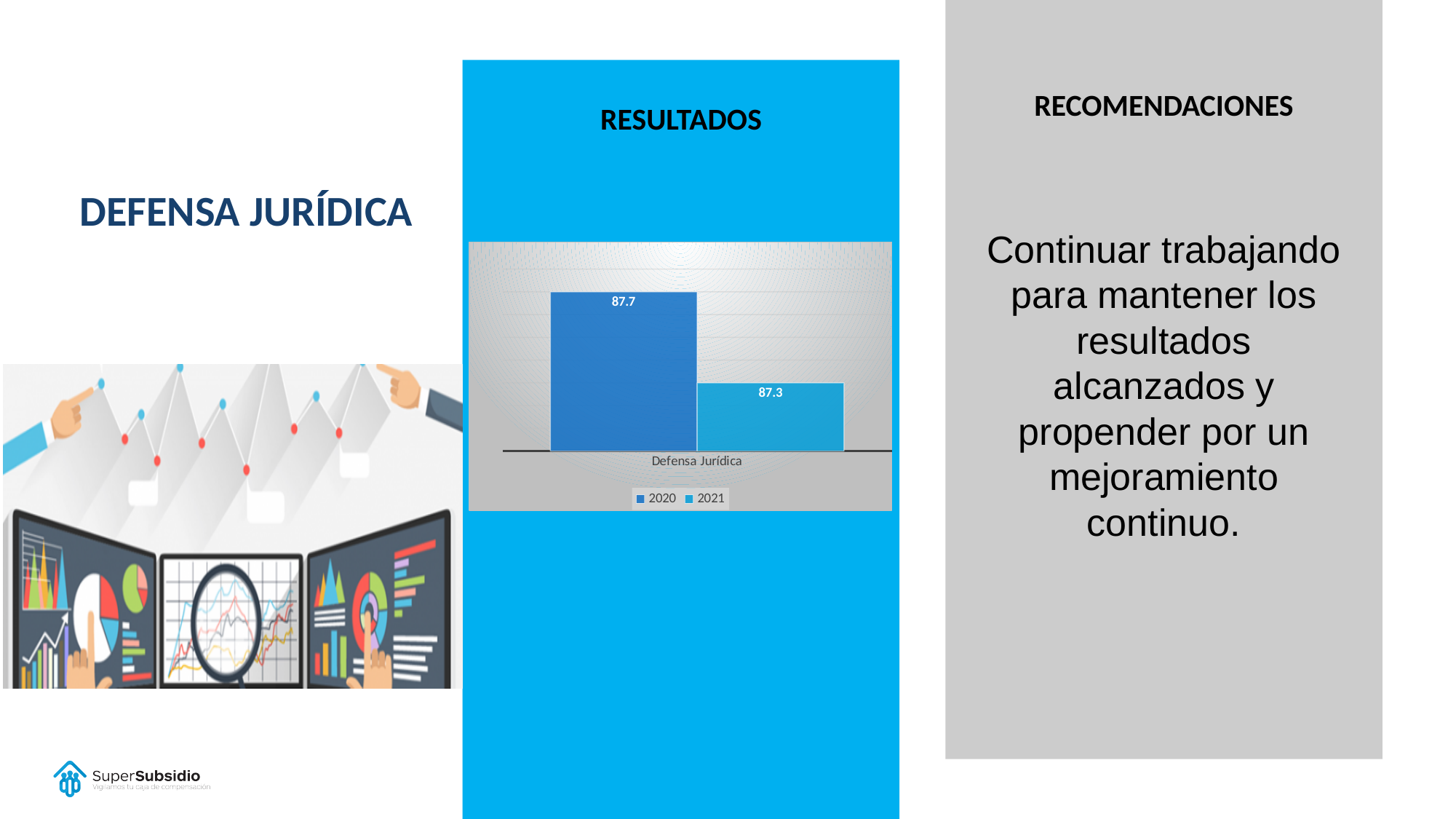
Did the value fall or rise from 2020 to 2021? Fall Which year shows the highest value in the chart? 2020 What is the value for 2020 in the chart? 87.7 Which series has the higher value, 2020 or 2021? 2020 What is the difference between the 2020 value and the 2021 value? 0.4 Which years are listed in the chart legend? 2020 and 2021 Which year shows the lowest value in the chart? 2021 What is the value for 2021 in the chart? 87.3 How many categories are shown on the x axis of the chart? 1 What kind of chart is shown on the slide? Bar chart How many series does the legend list? 2 What is the category label shown on the x axis of the chart? Defensa Jurídica